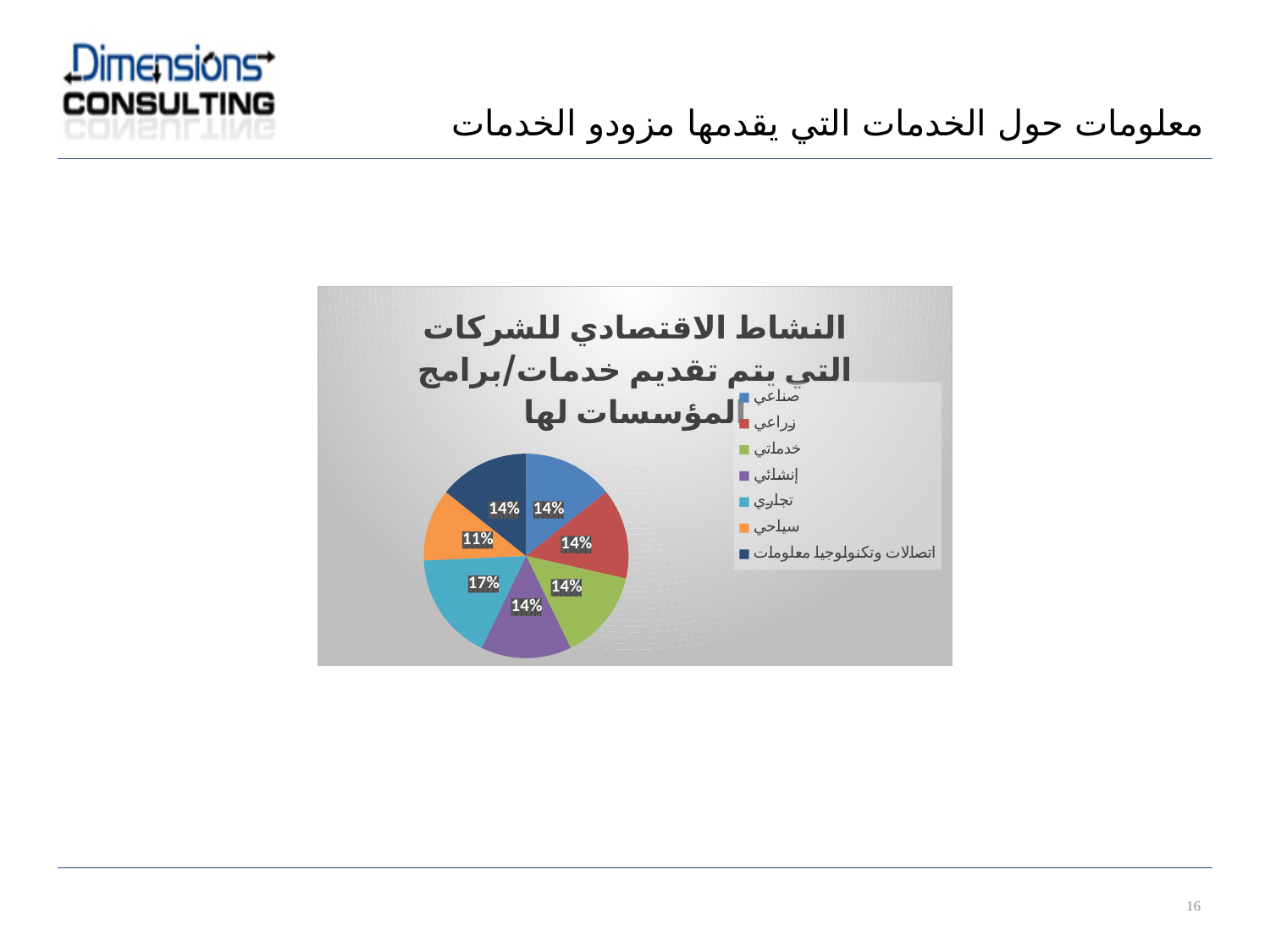
Which is larger, the slice for تجاري or the slice for زراعي? تجاري What share of the pie does سياحي have? 11% What is the difference in percentage points between the تجاري slice and the سياحي slice? 6 percentage points Which category has the smallest slice of the pie? سياحي How many categories does the pie chart have? 7 What share of the pie does تجاري have? 17% What colour is the slice for سياحي? orange Which category has the largest slice of the pie? تجاري What share of the pie does صناعي have? 14% How many entries does the legend list? 7 What kind of chart is shown on the slide? pie chart What share of the pie does اتصالات وتكنولوجيا معلومات have? 14%